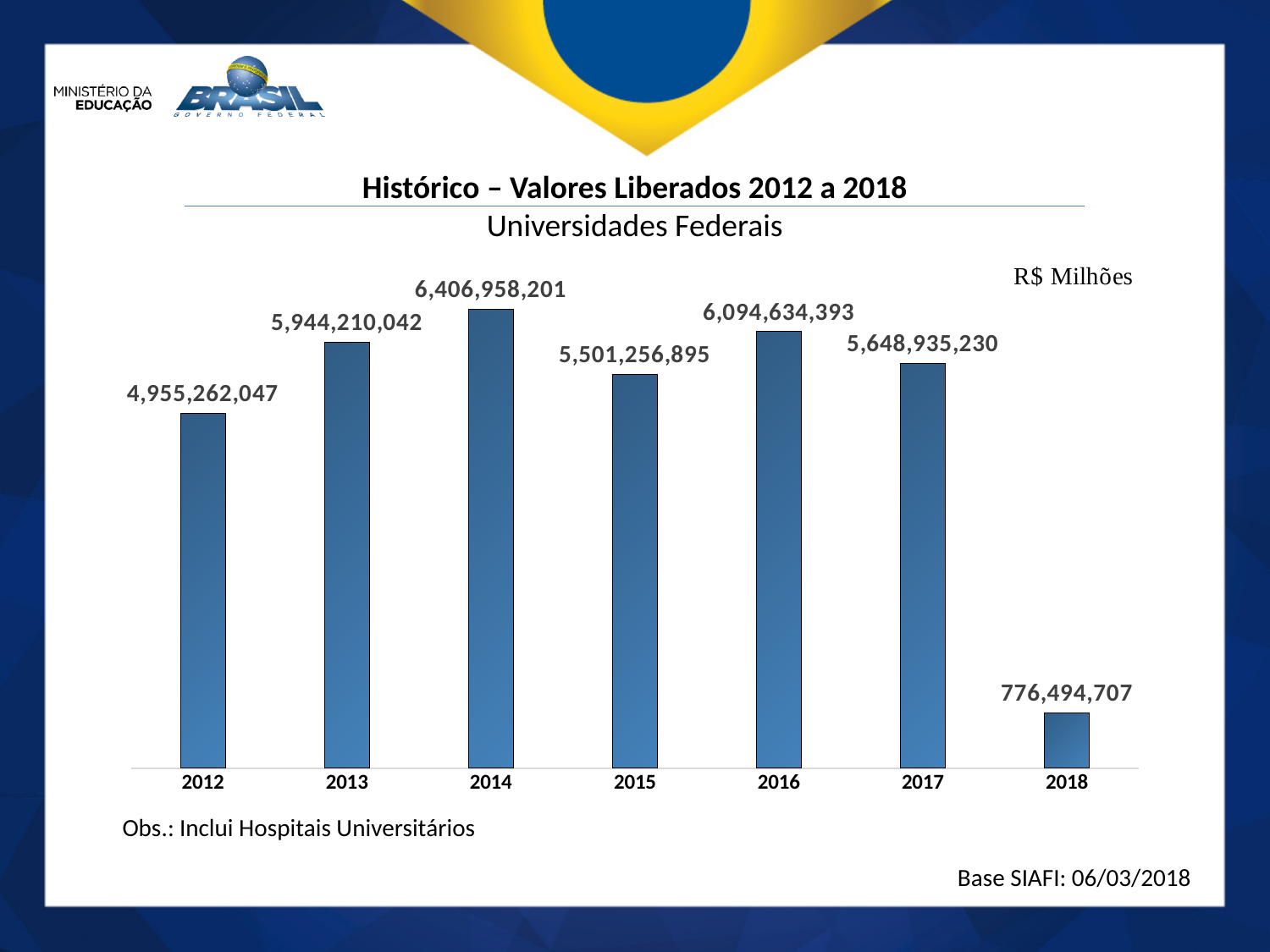
What value is shown for 2018? 776,494,707 What unit is indicated at the top right of the chart? R$ Milhões What value is shown for 2012? 4,955,262,047 Which is larger, the value for 2013 or the value for 2017? 2013 What value is shown for 2014? 6,406,958,201 Do the values rise or fall from 2012 to 2014? rise Which year has the highest value? 2014 Which year has the lowest value? 2018 How many years are shown on the x axis? 7 What is the difference between the values for 2016 and 2015? 593,377,498 What is the difference between the values for 2014 and 2012? 1,451,696,154 What kind of chart is this? bar chart